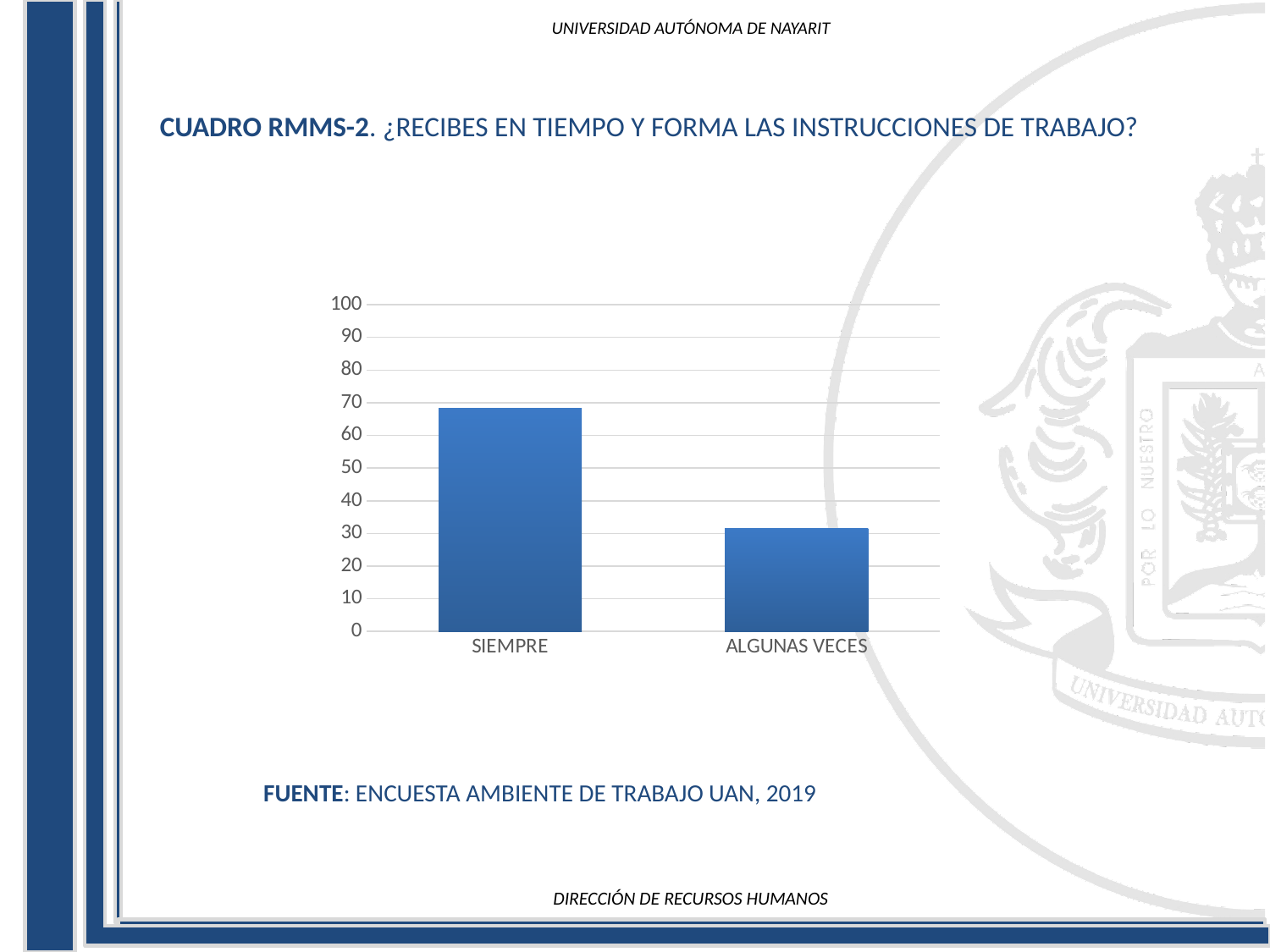
Is the value for ALGUNAS VECES greater or less than 20? greater What kind of chart is shown on the slide? bar chart Which category has the lowest bar in the chart? ALGUNAS VECES Is the value for SIEMPRE greater or less than 80? less Is the value for SIEMPRE greater or less than 60? greater Which is larger, the value for SIEMPRE or the value for ALGUNAS VECES? SIEMPRE What is the highest value shown on the chart's vertical axis? 100 Do the bar values rise or fall moving from SIEMPRE to ALGUNAS VECES along the x axis? fall Which category has the highest bar in the chart? SIEMPRE What source is cited below the chart? ENCUESTA AMBIENTE DE TRABAJO UAN, 2019 How many categories are plotted on the x axis of the chart? 2